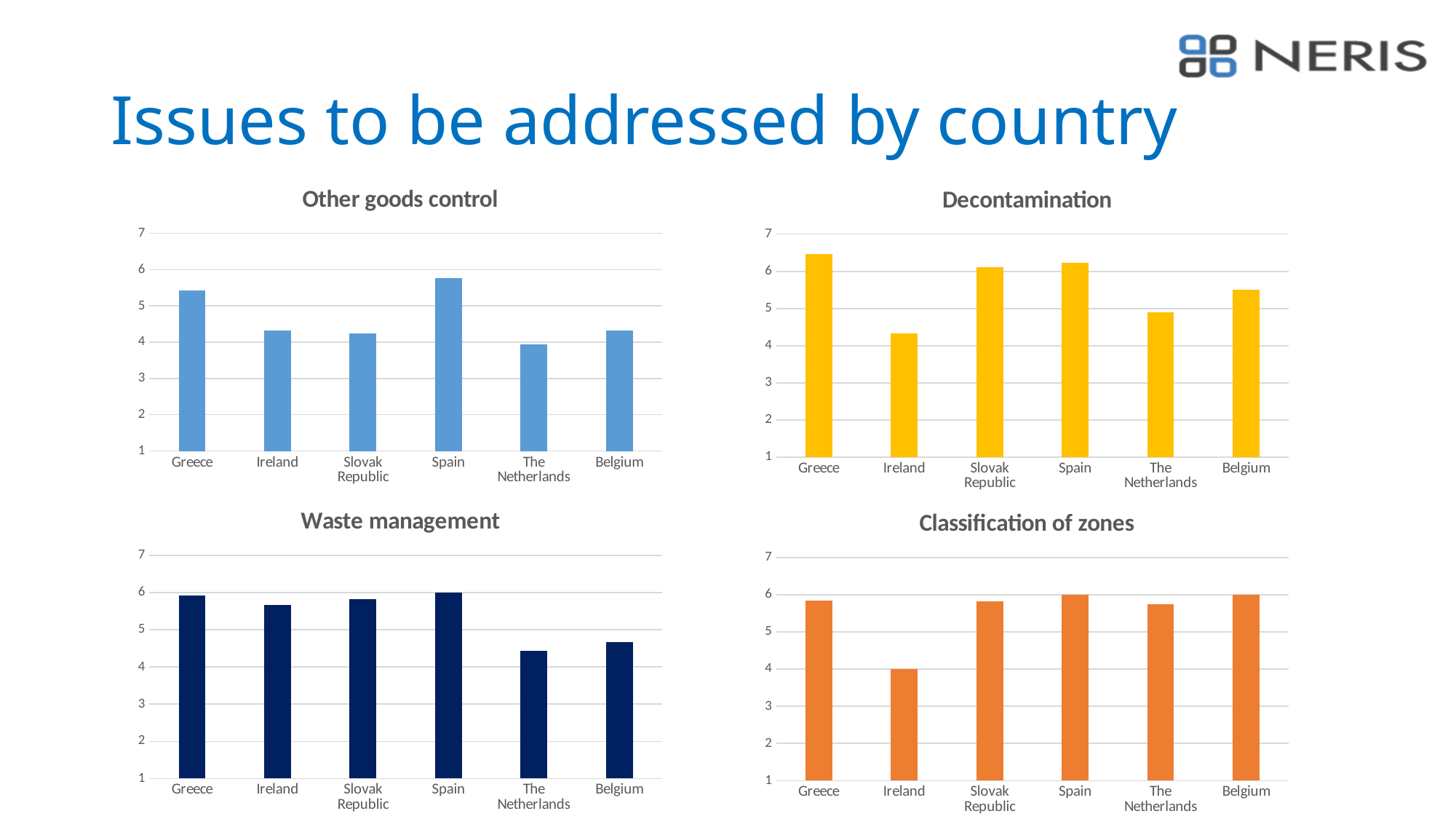
In the Decontamination chart, which country has the lowest value? Ireland In the Decontamination chart, is the value for The Netherlands greater or less than 5? less In the Other goods control chart, which country has the lowest value? The Netherlands In the Classification of zones chart, is the value for Spain greater or less than Ireland's? greater In the Decontamination chart, which country has the highest value? Greece In the Other goods control chart, which country has the highest value? Spain In the Waste management chart, is the value for Belgium greater or less than 5? less In the Waste management chart, which country has the lowest value? The Netherlands What type of chart is the Decontamination chart? bar chart How many countries are shown in the Waste management chart? 6